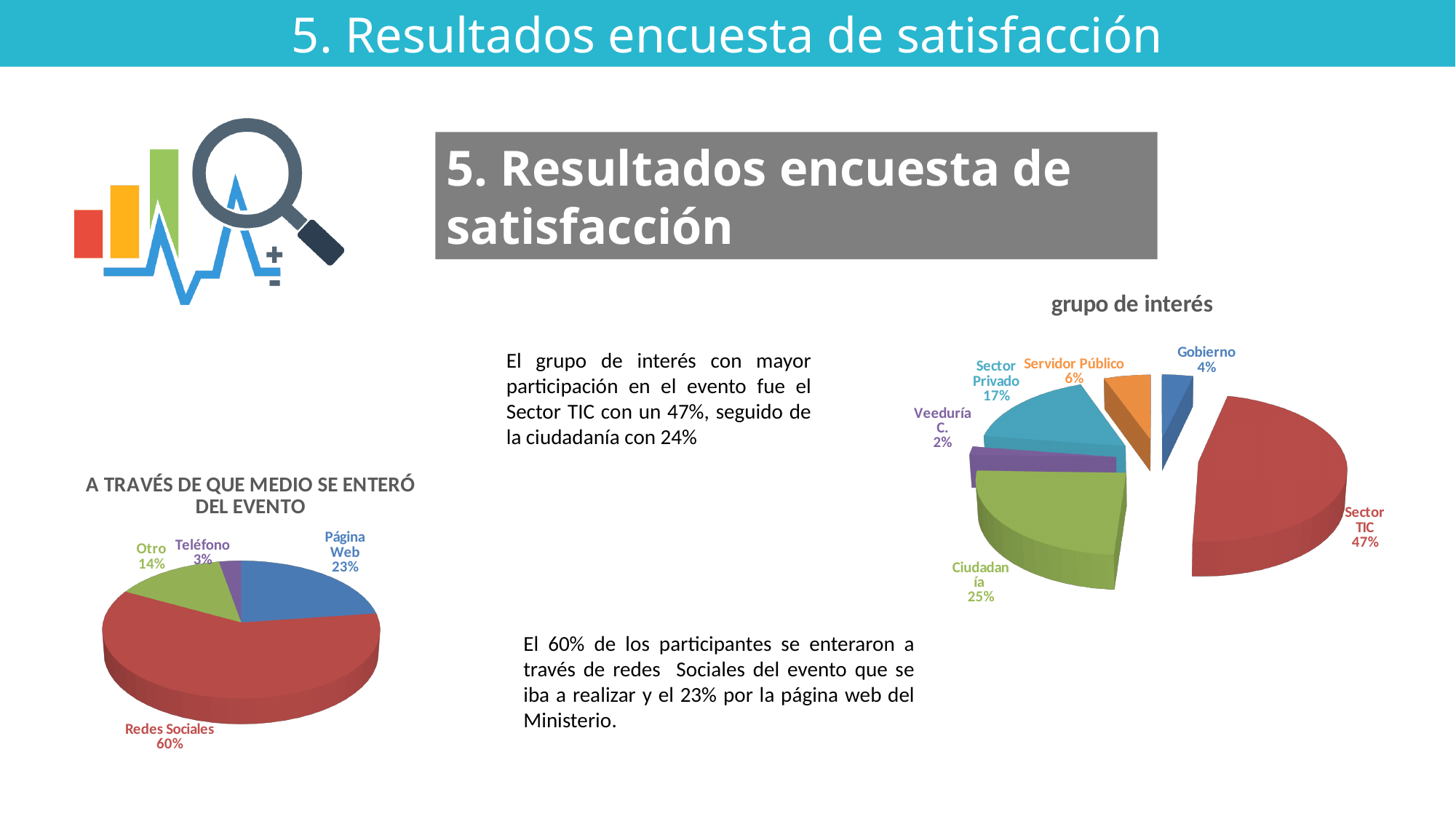
In the 'A TRAVÉS DE QUE MEDIO SE ENTERÓ DEL EVENTO' chart, what share does Redes Sociales have? 60% In the 'A TRAVÉS DE QUE MEDIO SE ENTERÓ DEL EVENTO' chart, which medium has the smallest share? Teléfono In the 'grupo de interés' chart, which is larger, Gobierno or Servidor Público? Servidor Público In the 'A TRAVÉS DE QUE MEDIO SE ENTERÓ DEL EVENTO' chart, what is the difference between Página Web and Otro? 9% In the 'grupo de interés' chart, what is the difference between Sector Privado and Servidor Público? 11% In the 'grupo de interés' chart, which group has the smallest share? Veeduría C. In the 'grupo de interés' chart, what share does Sector TIC have? 47% In the 'grupo de interés' chart, what share does Ciudadanía have? 25% In the 'grupo de interés' chart, how many groups are shown? 6 In the 'grupo de interés' chart, which group has the largest share? Sector TIC What kind of chart is the 'A TRAVÉS DE QUE MEDIO SE ENTERÓ DEL EVENTO' chart? Pie chart In the 'A TRAVÉS DE QUE MEDIO SE ENTERÓ DEL EVENTO' chart, what share does Otro have? 14%